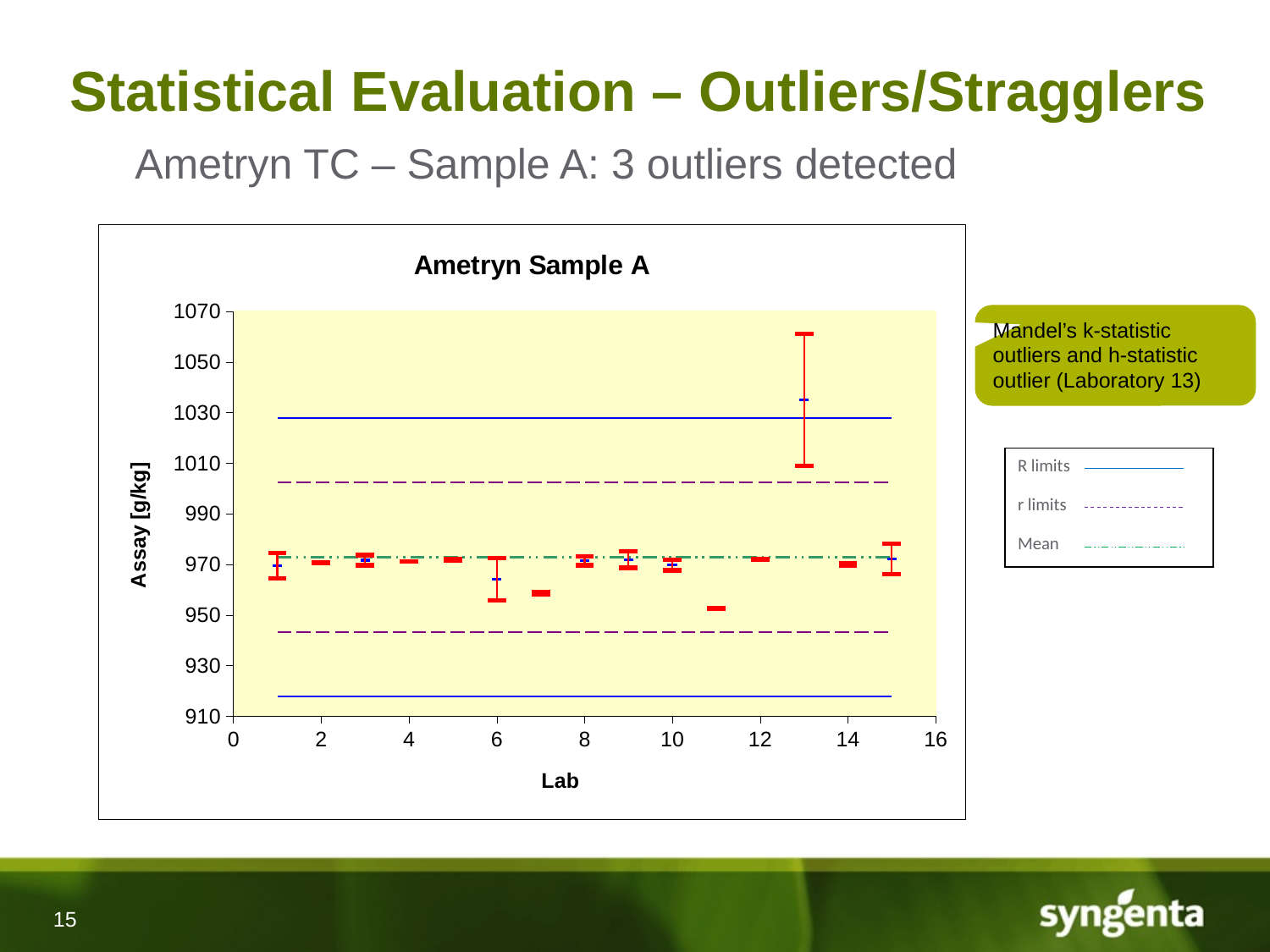
What is the label of the y axis? Assay [g/kg] Which lab has the lowest assay value? Lab 11 Is the lower R limit line greater or less than 930? less How many labs have data points plotted on the chart? 15 Is the assay value for Lab 13 greater or less than 1010? greater How many entries does the chart legend list? 3 Is the assay value for Lab 7 greater or less than 970? less Which has the larger assay value, Lab 13 or Lab 11? Lab 13 Which lab has the highest assay value? Lab 13 What is the title of the chart? Ametryn Sample A